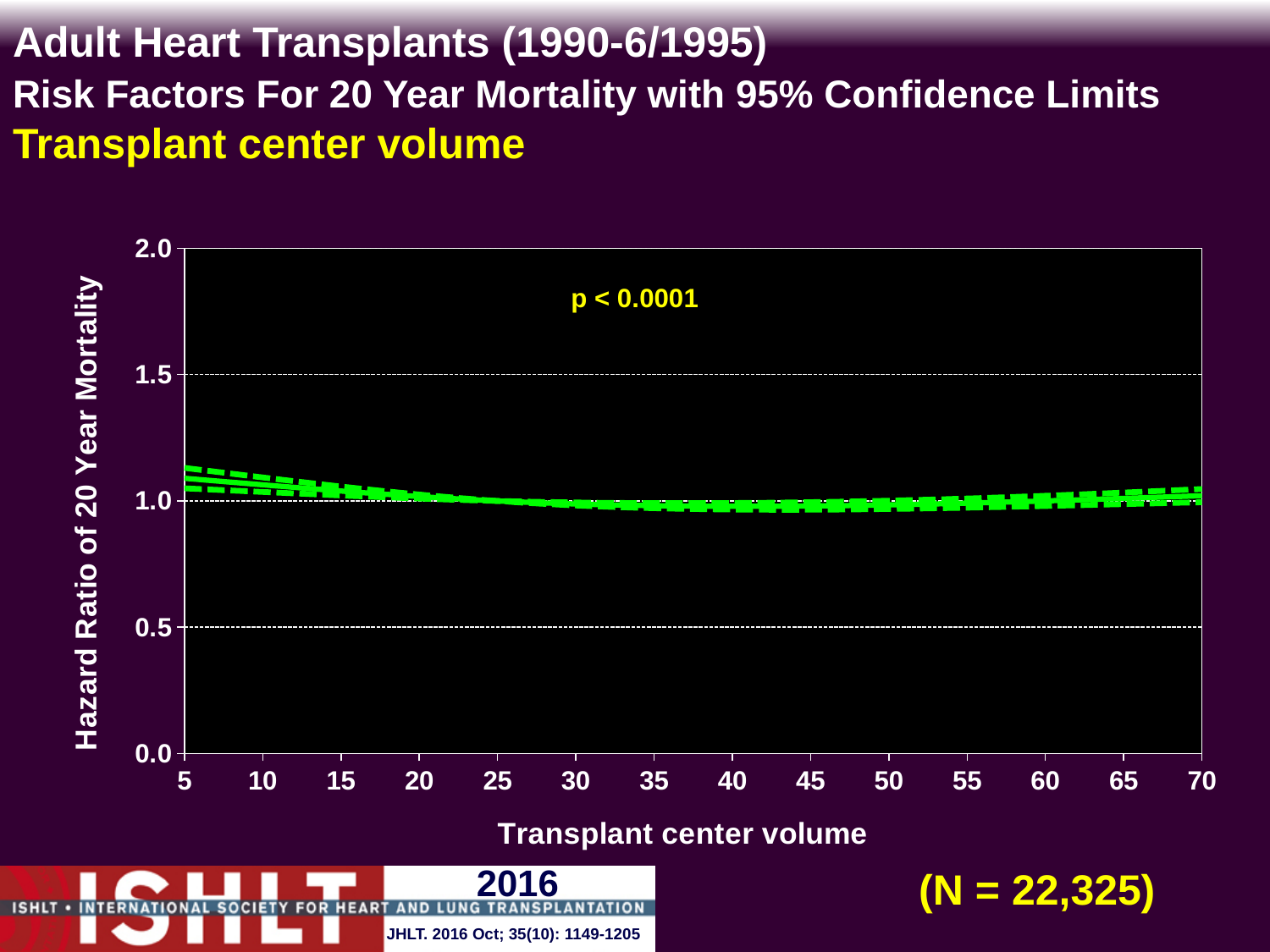
Is the hazard ratio at a transplant center volume of 40 greater or less than 1.5? less Is the hazard ratio at a transplant center volume of 10 greater or less than 1.5? less Is the hazard ratio at a transplant center volume of 5 greater or less than 1.0? greater What kind of chart is shown on the slide? line chart How many tick labels are shown on the x axis? 14 What p-value is printed on the chart? p < 0.0001 What is the highest value labelled on the y axis? 2.0 What is the lowest value labelled on the x axis? 5 Does the hazard ratio rise or fall as transplant center volume increases from 5 to 30? fall What colour are the plotted lines on the chart? green Is the hazard ratio at a transplant center volume of 5 higher or lower than at a volume of 40? higher